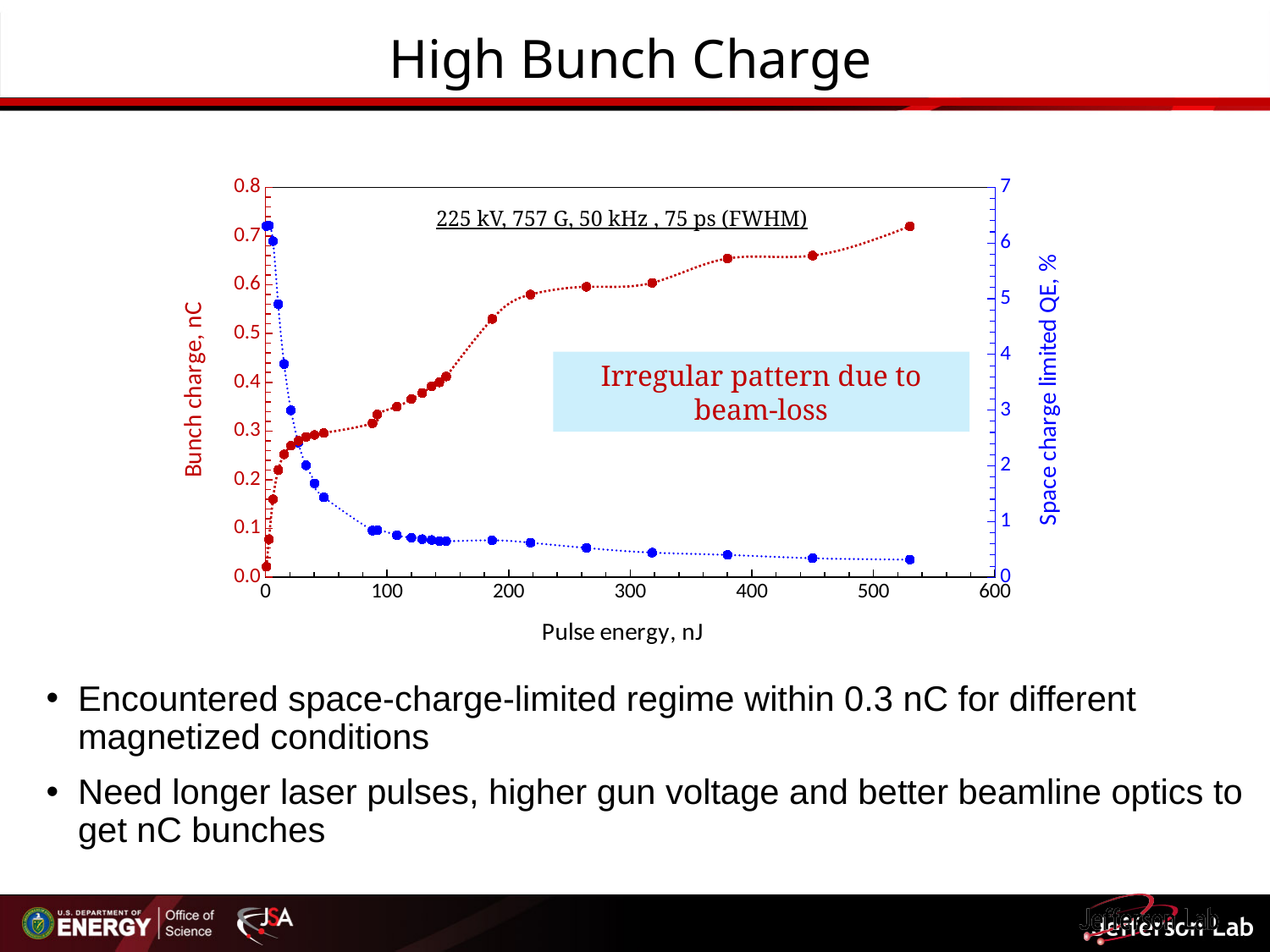
Is the space charge limited QE at the lowest pulse energy greater or less than 5%? greater What is the label of the x axis? Pulse energy, nJ How many data series are plotted on the chart? 2 What does the text box in the middle of the chart say? Irregular pattern due to beam-loss Is the bunch charge larger at about 200 nJ or at about 100 nJ pulse energy? 200 nJ Is the bunch charge at about 380 nJ pulse energy greater or less than 0.6 nC? greater Does the space charge limited QE (blue series) rise or fall as pulse energy increases? fall Is the space charge limited QE at about 530 nJ pulse energy greater or less than 1%? less Does the bunch charge (red series) rise or fall as pulse energy increases? rise What kind of chart is shown on the slide? line chart Is the space charge limited QE larger at about 100 nJ or at about 500 nJ pulse energy? 100 nJ